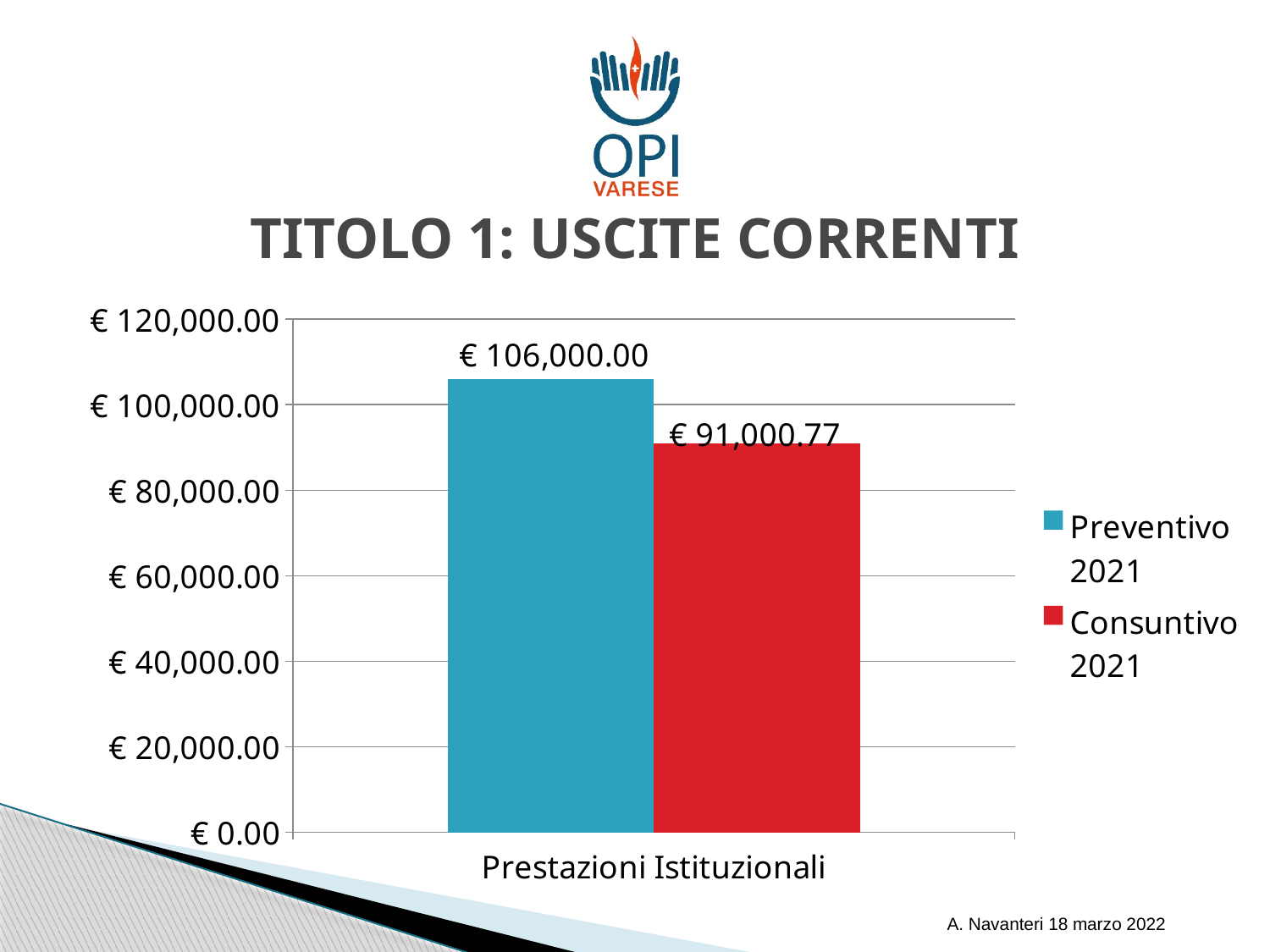
What is the category label on the x axis? Prestazioni Istituzionali Which series has the higher value for Prestazioni Istituzionali, Preventivo 2021 or Consuntivo 2021? Preventivo 2021 What is the difference between Preventivo 2021 and Consuntivo 2021 for Prestazioni Istituzionali? € 14,999.23 How many series does the legend list? 2 What is the value of Preventivo 2021 for Prestazioni Istituzionali? € 106,000.00 What colour is the bar for Consuntivo 2021? Red What kind of chart is shown on the slide? Bar chart What is the title of the chart? TITOLO 1: USCITE CORRENTI Is the value for Consuntivo 2021 greater or less than € 100,000.00? less What is the value of Consuntivo 2021 for Prestazioni Istituzionali? € 91,000.77 Is the value for Preventivo 2021 greater or less than € 100,000.00? greater How many categories are shown on the x axis? 1